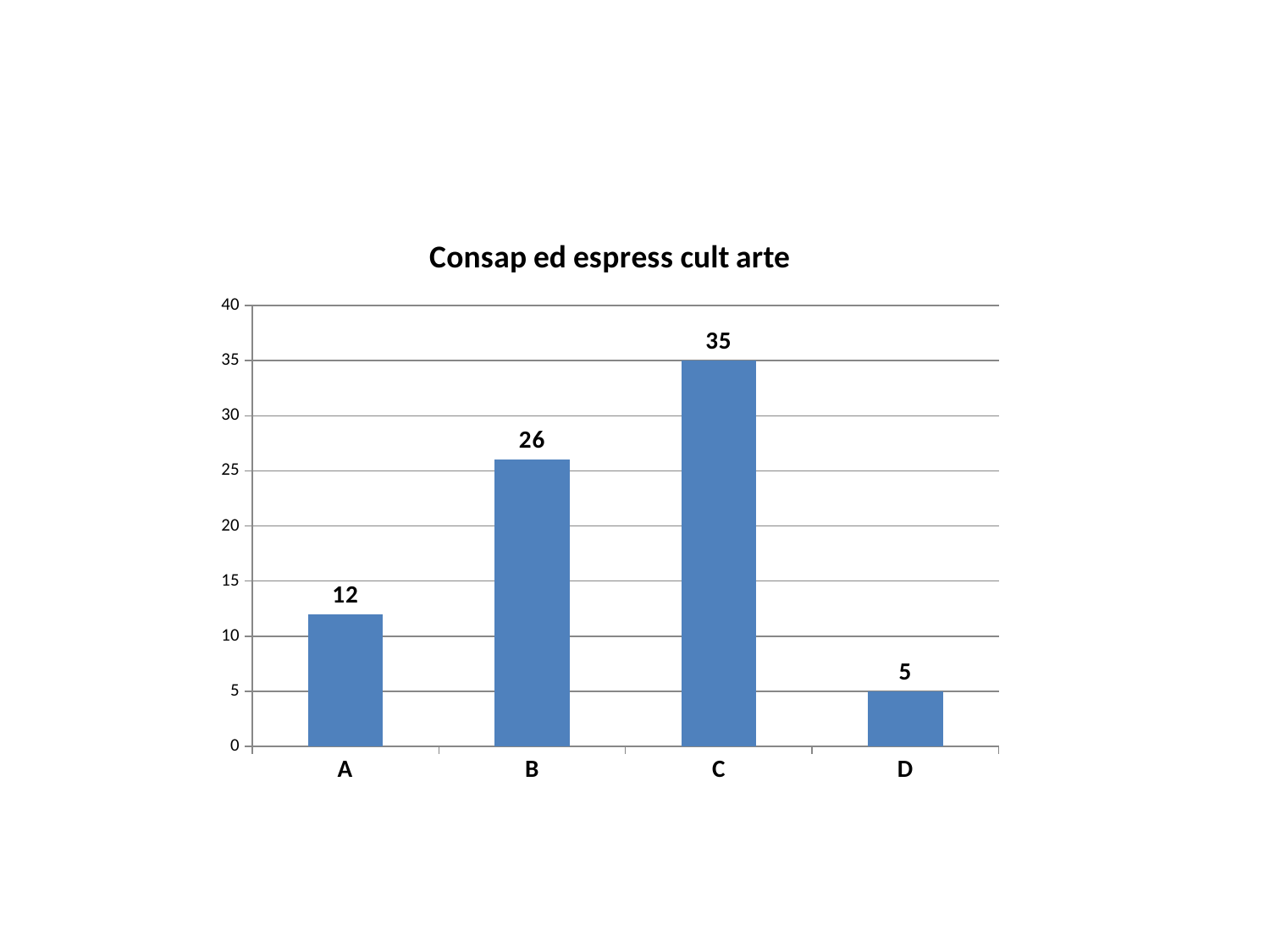
What is the difference between the values for A and D? 7 What is the value for category D? 5 What is the title of the chart? Consap ed espress cult arte What kind of chart is shown on the slide? Bar chart Which is larger, the value for A or the value for B? B What is the difference between the values for C and B? 9 How many categories are shown on the x axis? 4 Which category has the lowest value? D What is the value for category A? 12 What is the value for category C? 35 What is the value for category B? 26 Which category has the highest value? C